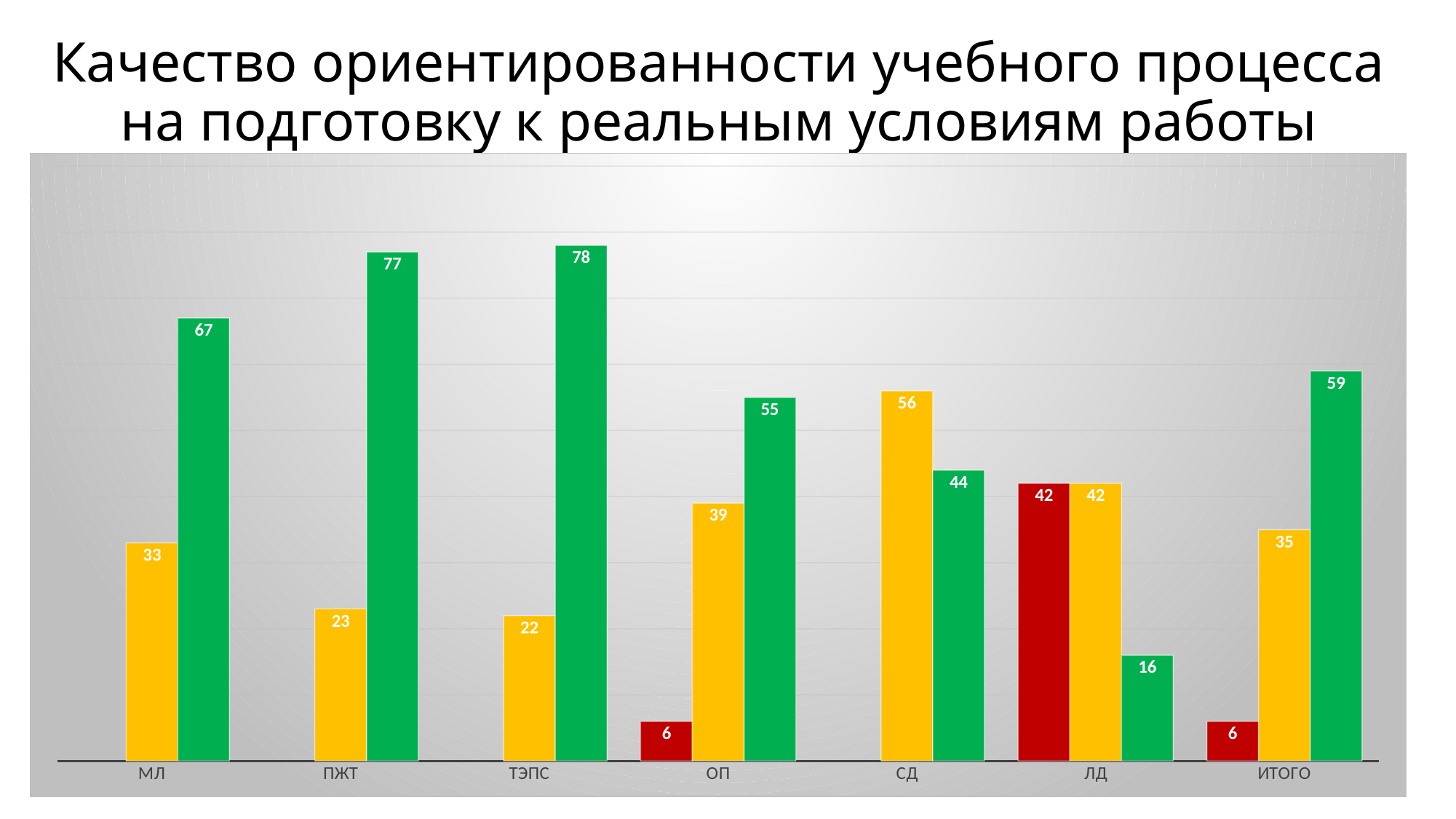
What is the difference between the green bar and the yellow bar for МЛ? 34 How many categories have a red bar? 3 What is the value of the red bar for ЛД? 42 What kind of chart is shown on the slide? bar chart What is the value of the yellow bar for СД? 56 Which is larger for СД, the yellow bar or the green bar? the yellow bar What is the value of the green bar for ТЭПС? 78 How many categories are shown on the x axis? 7 Which category has the highest green bar? ТЭПС Which category has the lowest green bar? ЛД What is the title of the chart on the slide? Качество ориентированности учебного процесса на подготовку к реальным условиям работы What is the value of the yellow bar for ИТОГО? 35